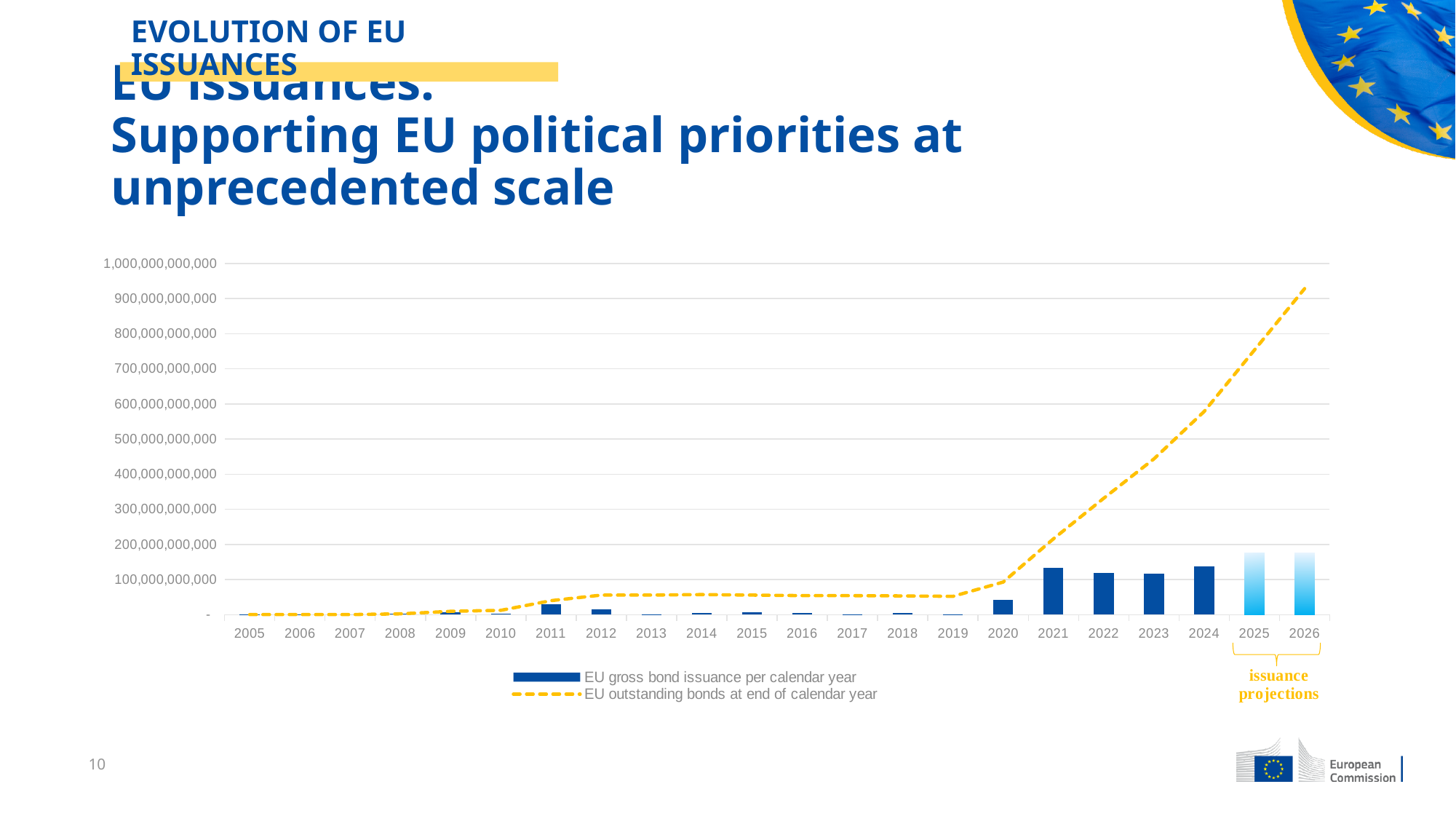
Is the value of EU outstanding bonds at end of 2026 greater or less than 900,000,000,000? greater Is the EU gross bond issuance for 2021 greater or less than 100,000,000,000? greater Which year has the larger EU gross bond issuance, 2024 or 2025? 2025 What kind of chart is shown on the slide? A combined bar and line chart Is the value of EU outstanding bonds at end of 2019 greater or less than 100,000,000,000? less Which year has the larger EU gross bond issuance, 2020 or 2021? 2021 How many series does the legend list? 2 Which years are marked as issuance projections? 2025 and 2026 How many years are shown on the x axis? 22 Does the EU outstanding bonds line rise or fall from 2020 to 2026? Rises